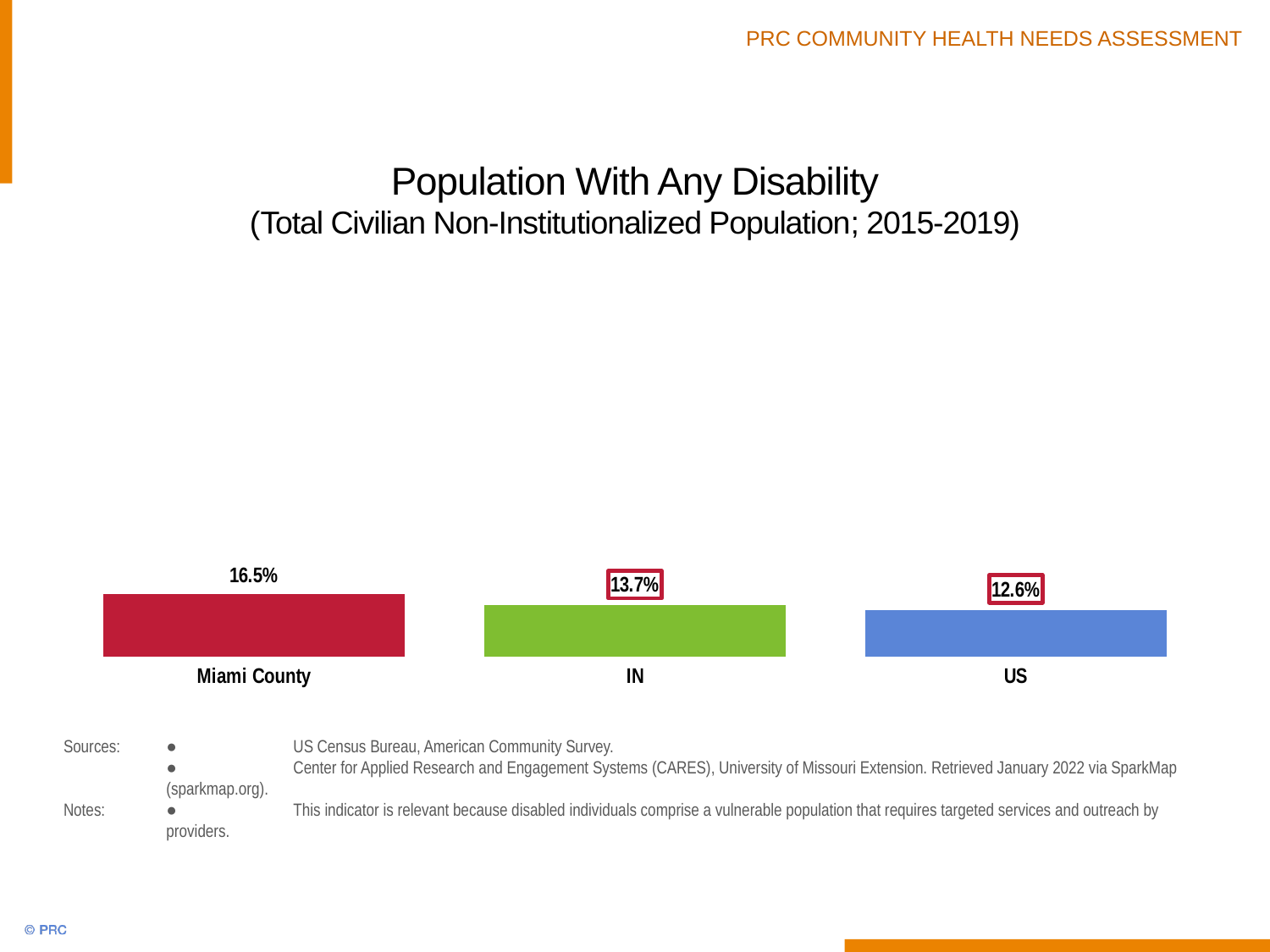
Which is larger, the value for Miami County or the value for IN? Miami County What is the value for IN? 13.7% What is the title of the chart? Population With Any Disability (Total Civilian Non-Institutionalized Population; 2015-2019) Which category has the lowest value? US What is the value for Miami County? 16.5% Do the values rise or fall from left to right across the categories? Fall What is the difference between the values for IN and US? 1.1% What is the difference between the values for Miami County and US? 3.9% What is the value for US? 12.6% How many categories are shown in the chart? 3 Which category has the highest value? Miami County What kind of chart is shown on the slide? Bar chart